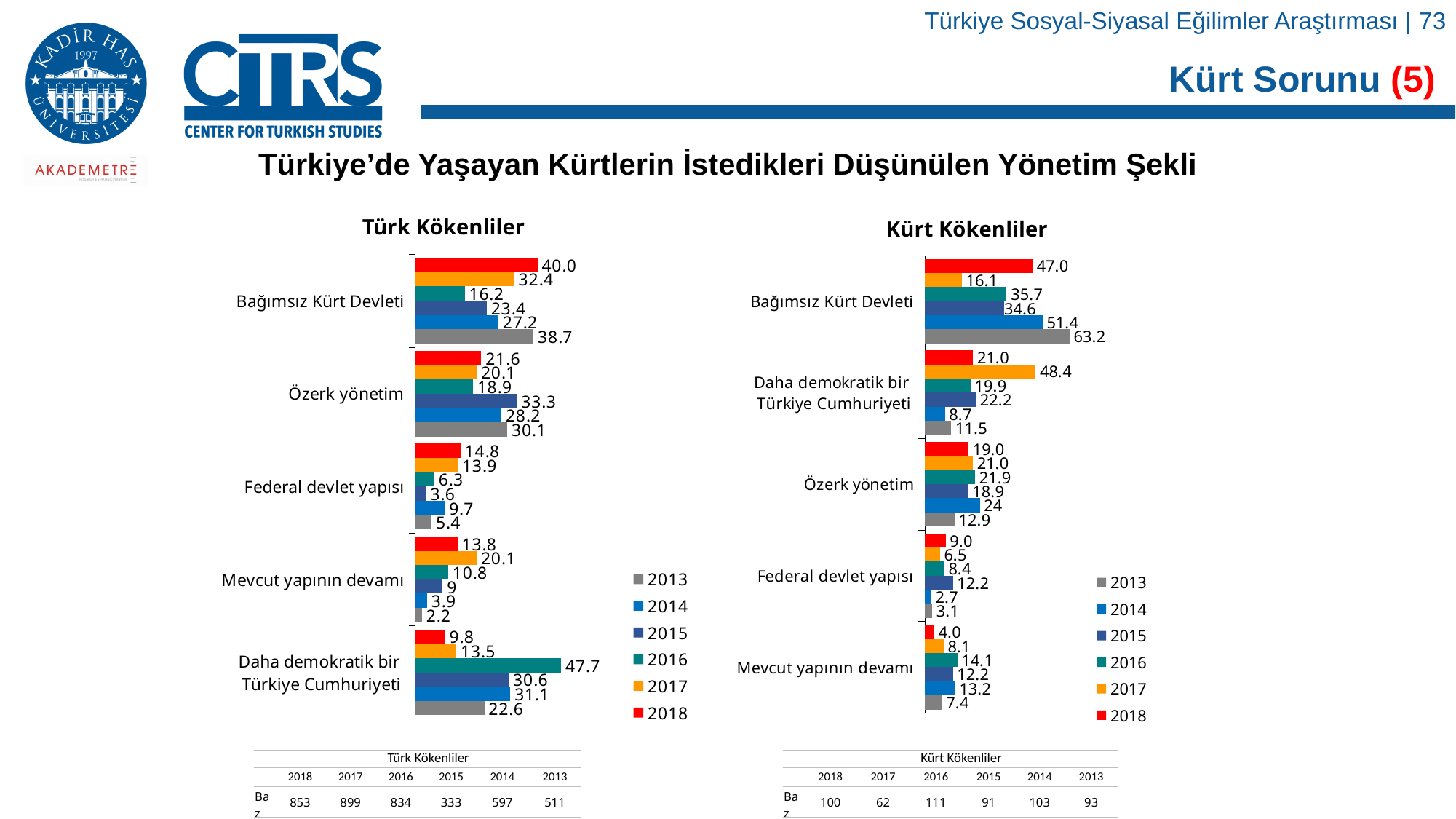
In the Türk Kökenliler chart, what is the 2018 value for Bağımsız Kürt Devleti? 40.0 In the Türk Kökenliler chart, what is the difference between the 2018 and 2017 values for Bağımsız Kürt Devleti? 7.6 What type of chart is the Türk Kökenliler chart? Bar chart In the Kürt Kökenliler chart, which category has the highest 2018 value? Bağımsız Kürt Devleti In the Kürt Kökenliler chart, what is the 2013 value for Bağımsız Kürt Devleti? 63.2 How many categories are shown in the Kürt Kökenliler chart? 5 In the Kürt Kökenliler chart, which is larger for Özerk yönetim: the 2014 value or the 2013 value? 2014 In the Türk Kökenliler chart, what is the 2016 value for Daha demokratik bir Türkiye Cumhuriyeti? 47.7 In the Türk Kökenliler chart, which category has the lowest 2013 value? Mevcut yapının devamı In the Kürt Kökenliler chart, what is the difference between the 2015 and 2014 values for Federal devlet yapısı? 9.5 In the Kürt Kökenliler chart, what is the 2017 value for Daha demokratik bir Türkiye Cumhuriyeti? 48.4 How many series does the legend of the Türk Kökenliler chart list? 6